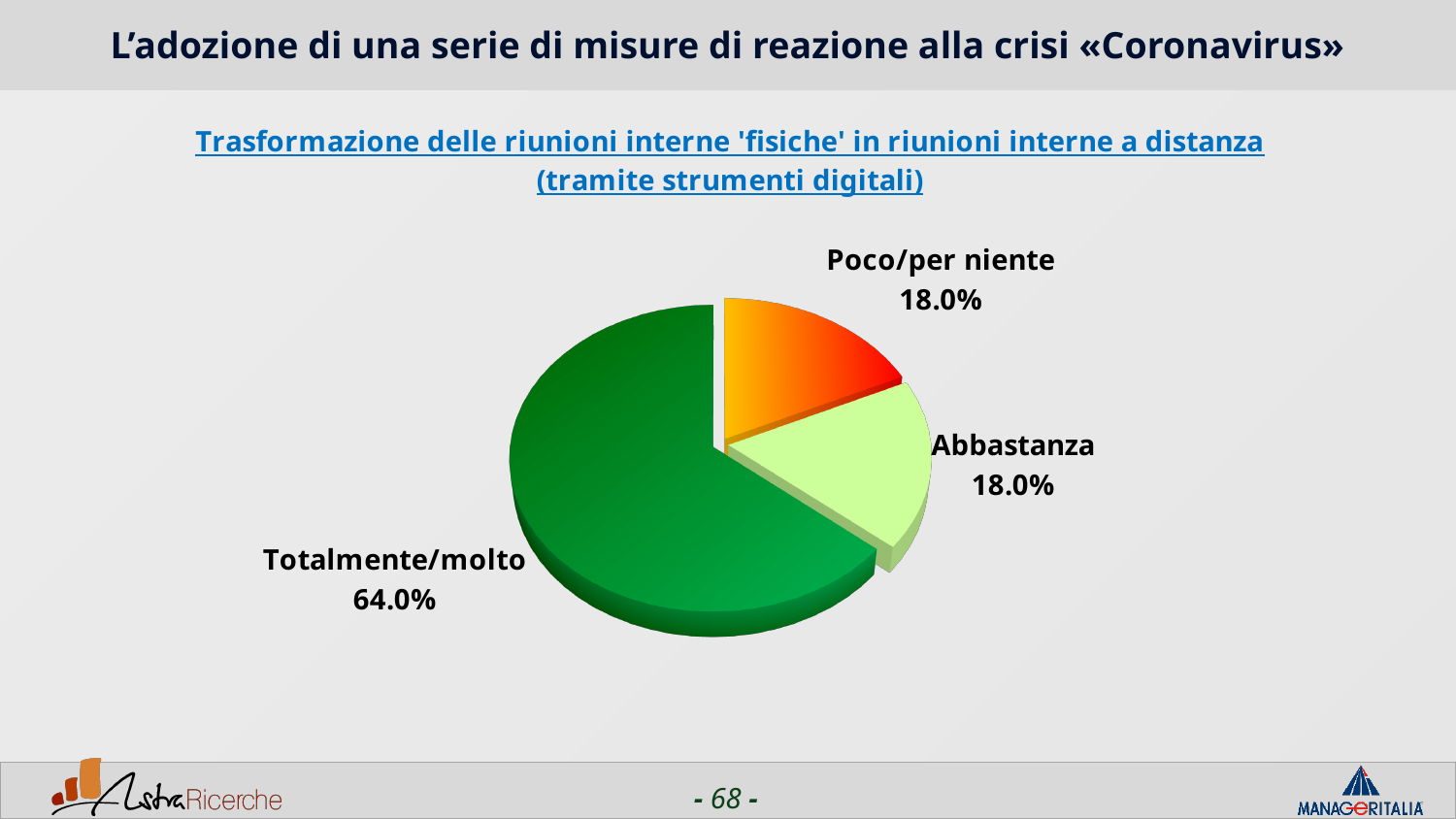
What is the value for 'Abbastanza'? 18.0% Which category has the largest share of the pie? Totalmente/molto What is the value for 'Totalmente/molto'? 64.0% What colour is the 'Totalmente/molto' slice? Green What is the difference between the values for 'Totalmente/molto' and 'Abbastanza'? 46.0% What kind of chart is shown on the slide? Pie chart Which is larger, the value for 'Totalmente/molto' or the value for 'Poco/per niente'? Totalmente/molto What is the value for 'Poco/per niente'? 18.0% What is the combined value of 'Abbastanza' and 'Poco/per niente'? 36.0% How many slices does the pie chart have? 3 What is the title of the chart? Trasformazione delle riunioni interne 'fisiche' in riunioni interne a distanza (tramite strumenti digitali)